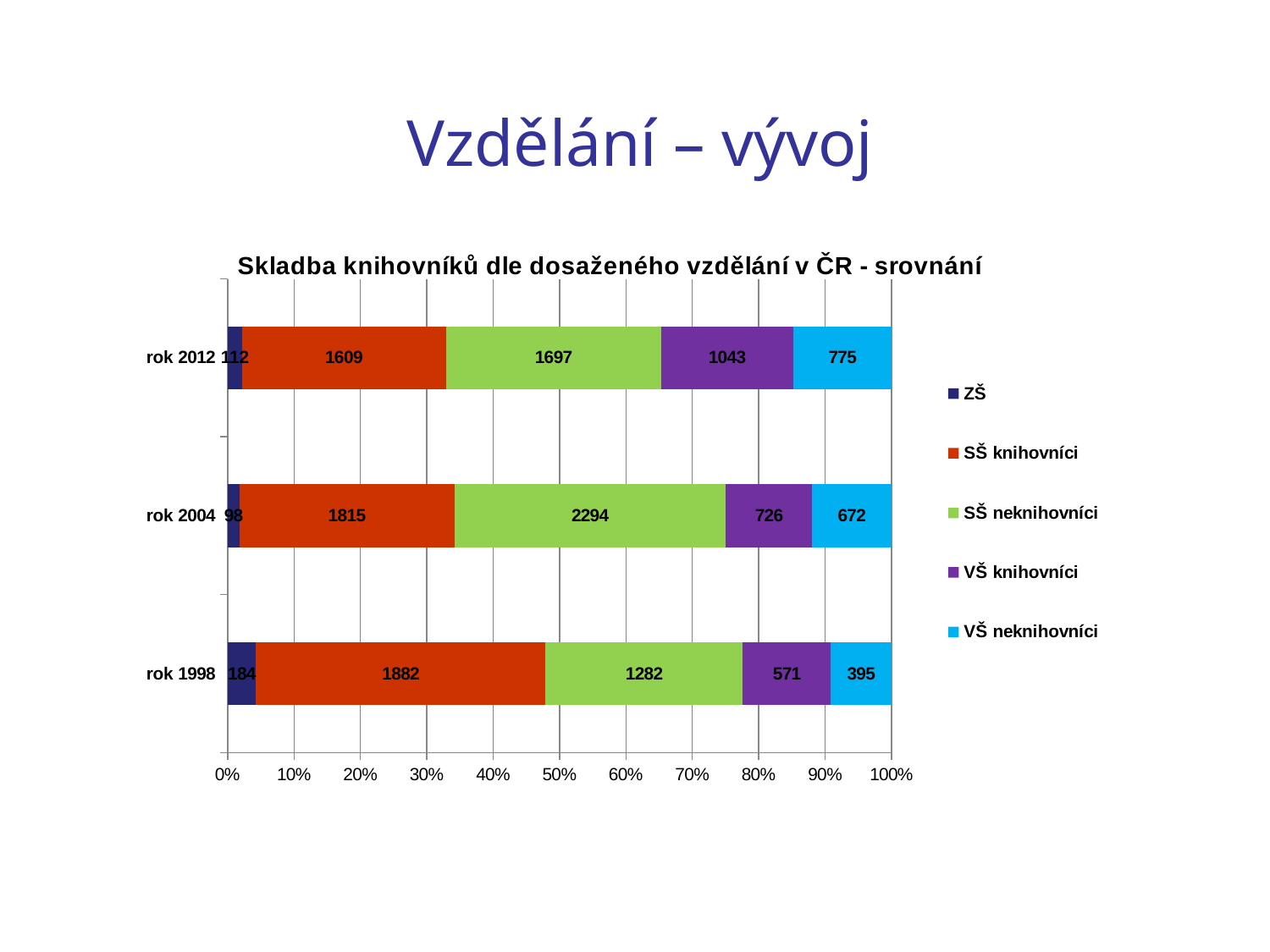
What is the difference between the SŠ knihovníci values for rok 1998 and rok 2012? 273 Which year has the highest value for VŠ neknihovníci? rok 2012 What is the value for ZŠ in rok 1998? 184 Which year has the lowest value for ZŠ? rok 2004 How many years (categories) are shown on the chart? 3 Which is larger: VŠ knihovníci in rok 2004 or VŠ knihovníci in rok 1998? rok 2004 What is the value for SŠ neknihovníci in rok 2004? 2294 What is the title of the chart? Skladba knihovníků dle dosaženého vzdělání v ČR - srovnání What kind of chart is shown on the slide? stacked bar chart What is the value for VŠ knihovníci in rok 2012? 1043 How many series does the legend list? 5 What is the total of all segments in the rok 2012 bar? 5236